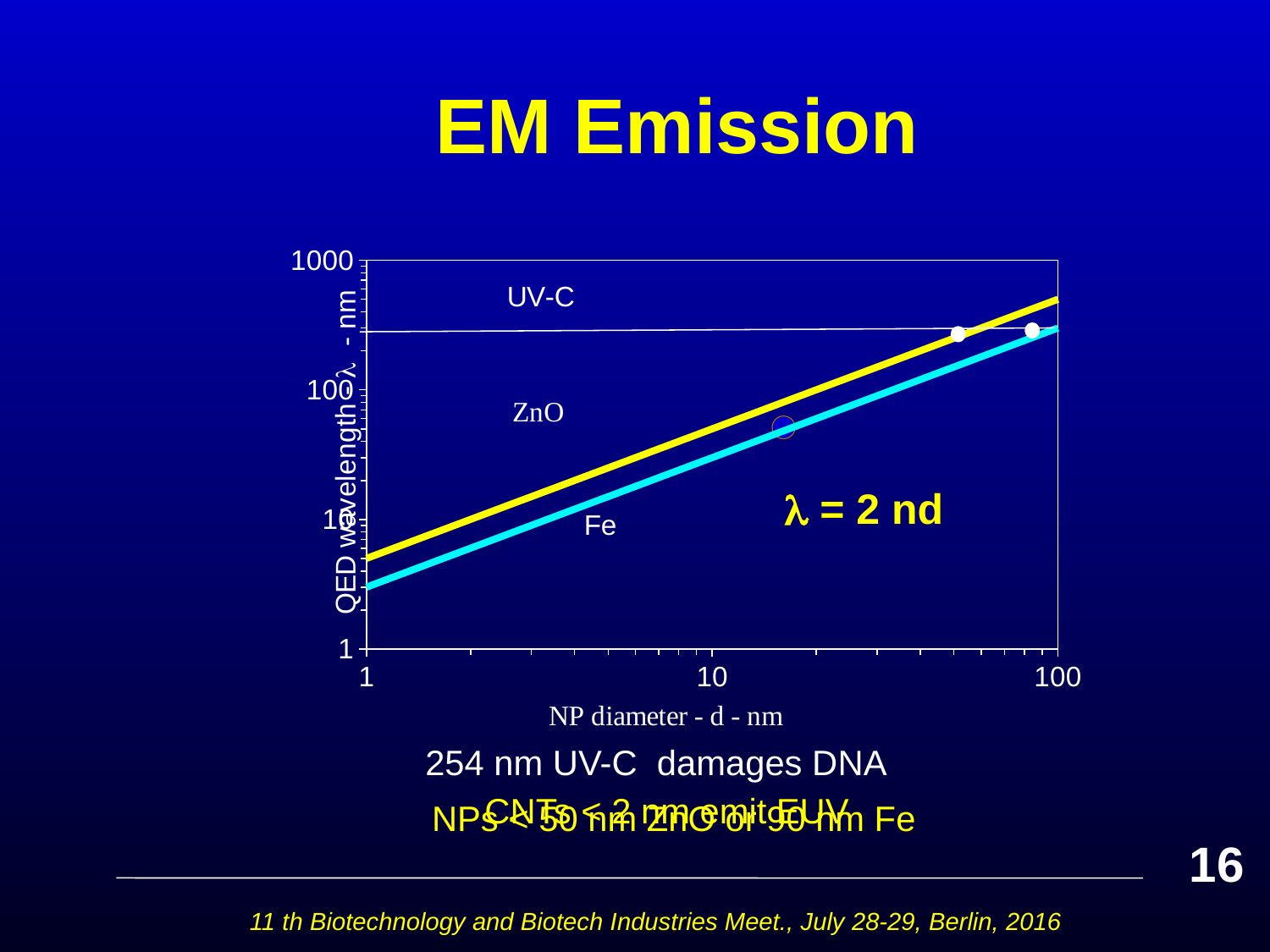
What is the highest value shown on the y axis of the chart? 1000 Is the QED wavelength for Fe at a diameter of 10 nm greater or less than 100? less Is the QED wavelength for Fe at a diameter of 100 nm greater or less than 100? greater Is the QED wavelength for Fe at a diameter of 1 nm greater or less than 10? less What is the label of the x axis of the chart? NP diameter - d - nm Which line lies higher on the chart, ZnO or Fe? ZnO What kind of chart is shown on the slide? line chart Do the ZnO and Fe lines rise or fall as NP diameter increases? rise How many material lines (ZnO and Fe) are plotted on the chart? 2